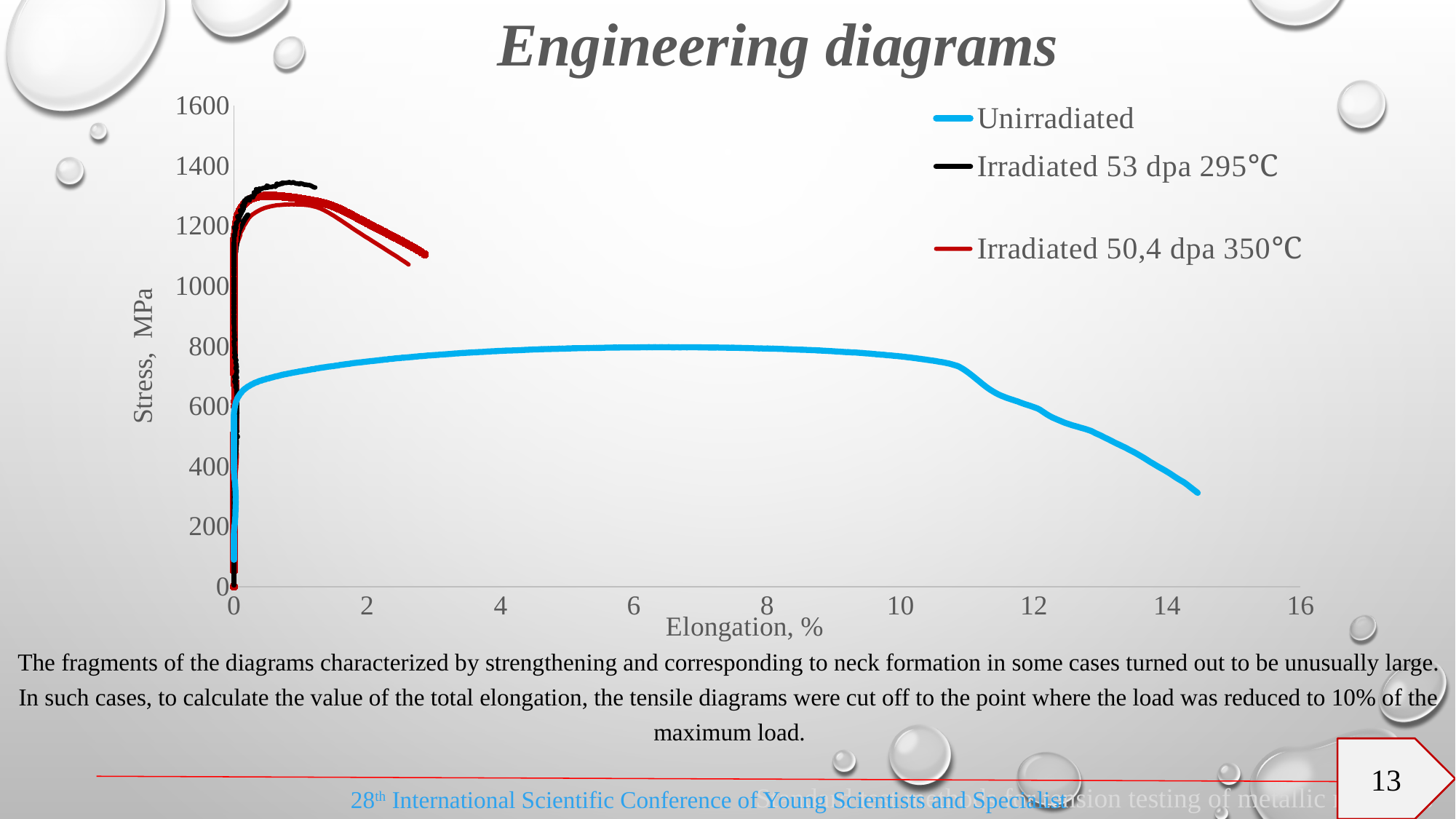
What is the title of the chart on the slide? Engineering diagrams Is the maximum elongation of the Irradiated 50,4 dpa 350℃ series greater or less than 4%? less Is the maximum stress of the Irradiated 53 dpa 295℃ series greater or less than 1200 MPa? greater What is the label of the vertical axis? Stress, MPa Is the maximum stress of the Unirradiated series greater or less than 1000 MPa? less Which series reaches the largest elongation? Unirradiated Does the stress of the Unirradiated series rise or fall between 12% and 14% elongation? fall Which series reaches a higher maximum stress, Unirradiated or Irradiated 50,4 dpa 350℃? Irradiated 50,4 dpa 350℃ What kind of chart is shown on the slide? line chart How many series does the legend list? 3